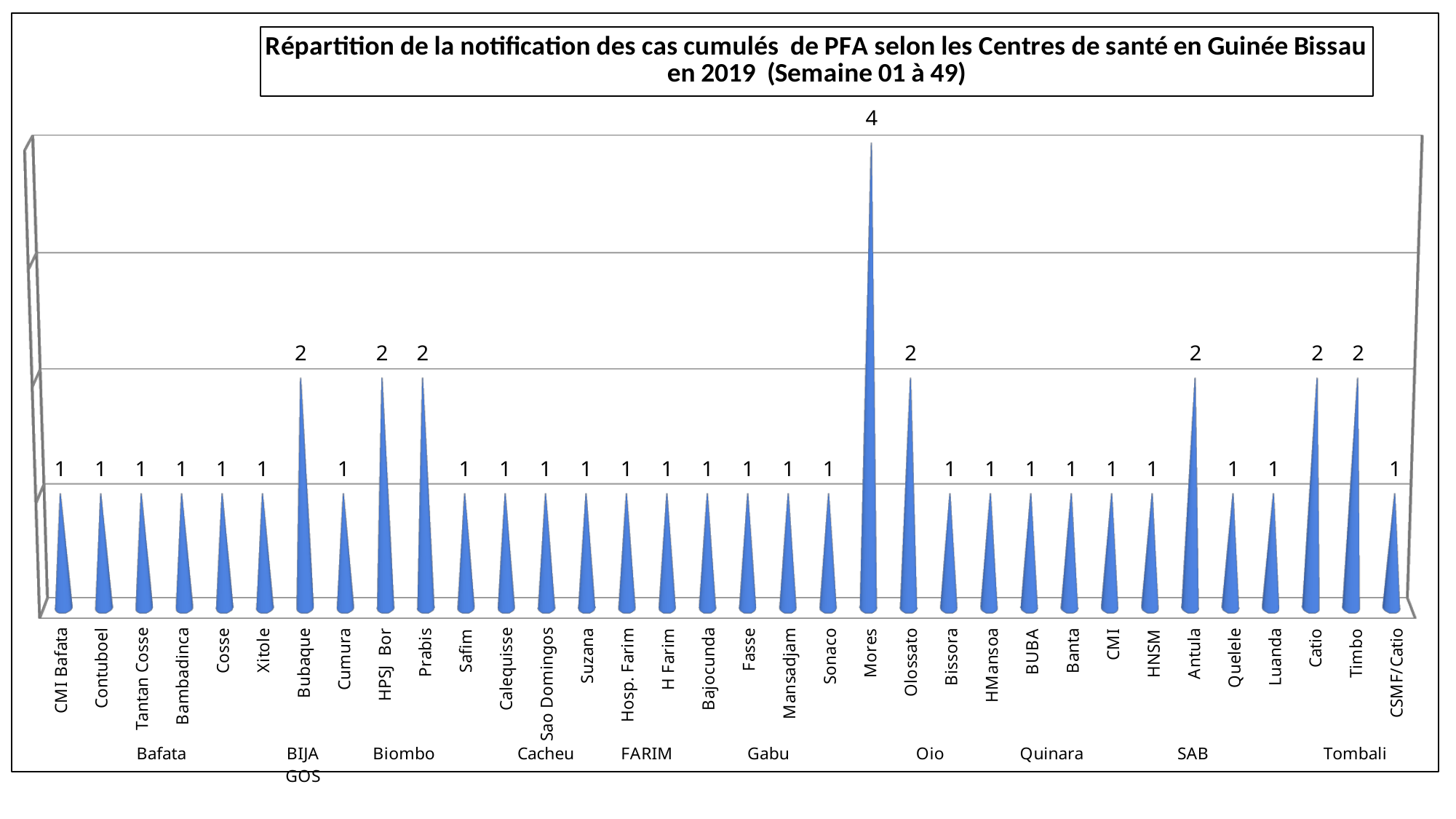
Which is larger, the value for Catio or the value for CSMF/Catio? Catio How many health centres are shown on the x axis? 34 What is the difference between the values for Mores and Olossato? 2 What is the value for Bubaque? 2 What is the value for Mores? 4 Which health centre has the highest number of cumulative PFA cases? Mores What is the title of the chart? Répartition de la notification des cas cumulés de PFA selon les Centres de santé en Guinée Bissau en 2019 (Semaine 01 à 49) What kind of chart is this? Bar chart What is the difference between the values for Prabis and Safim? 1 Which is larger, the value for Antula or the value for Quelele? Antula What is the value for Contuboel? 1 What is the value for Timbo? 2